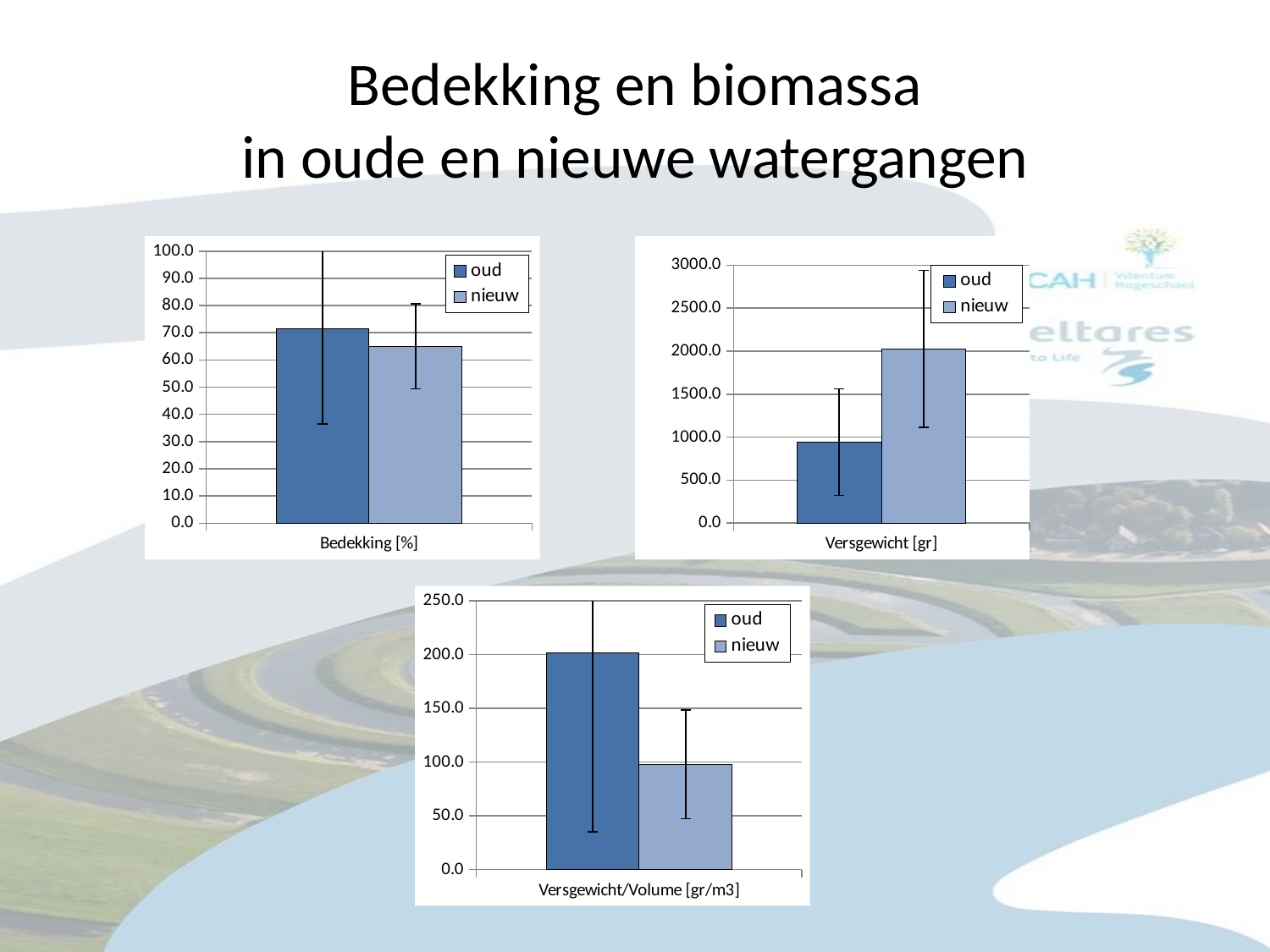
In the Bedekking [%] chart, is the value for nieuw greater or less than 70.0? less In the Versgewicht [gr] chart, is the value for nieuw greater or less than 1500.0? greater What kind of chart is the Bedekking [%] chart? bar chart In the Versgewicht/Volume [gr/m3] chart, is the value for nieuw greater or less than 150.0? less In the Versgewicht [gr] chart, which series has the higher value, oud or nieuw? nieuw How many charts are shown on the slide? 3 How many series does the legend of the Versgewicht [gr] chart list? 2 In the Versgewicht/Volume [gr/m3] chart, which series has the higher value, oud or nieuw? oud In the Bedekking [%] chart, which series has the taller bar, oud or nieuw? oud